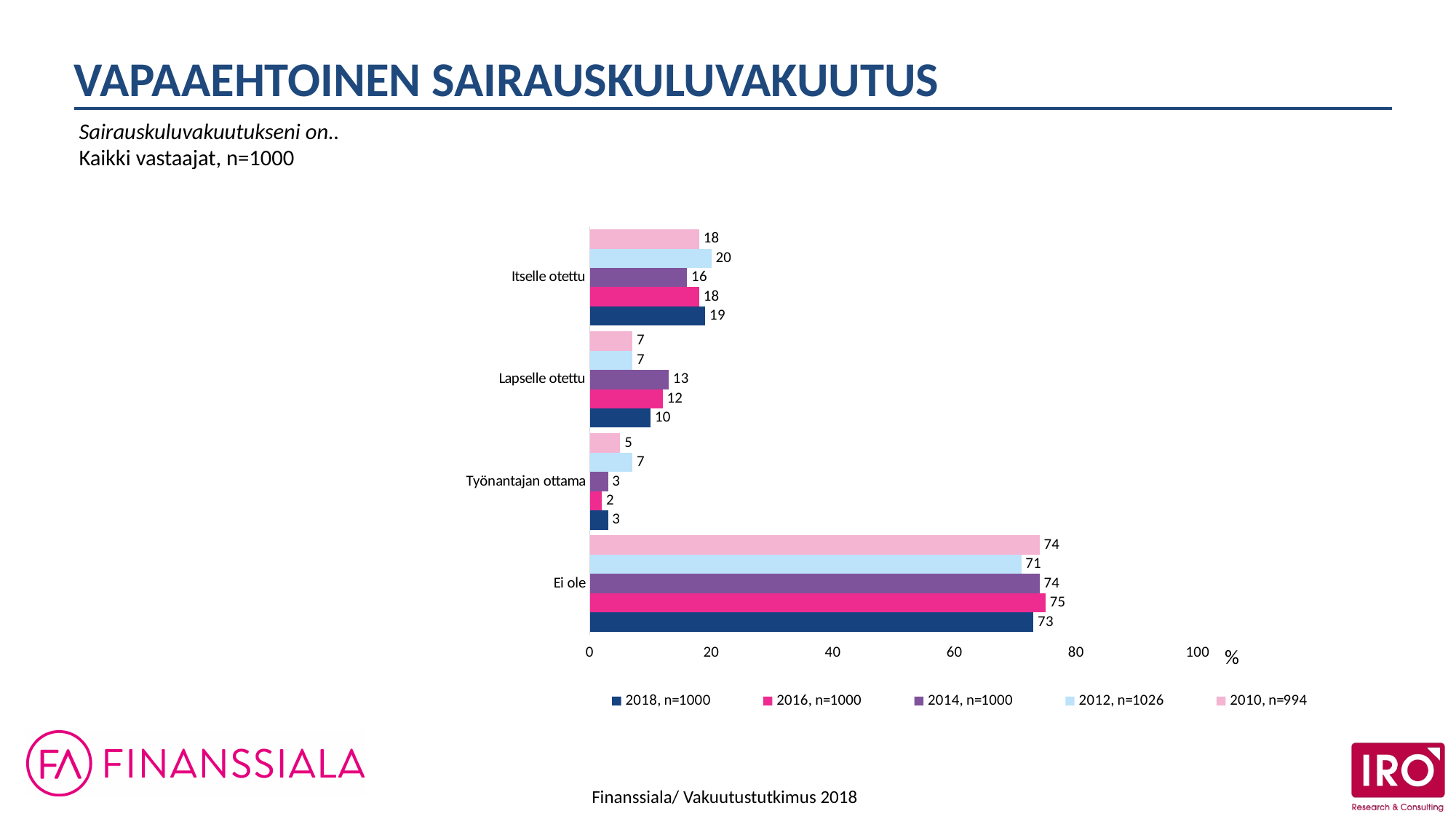
What kind of chart is shown on the slide? Bar chart What is the value for 'Työnantajan ottama' in the 2016, n=1000 series? 2 How many series does the legend list? 5 Which is larger for 'Lapselle otettu': the 2016, n=1000 value or the 2010, n=994 value? 2016, n=1000 What is the value for 'Itselle otettu' in the 2018, n=1000 series? 19 How many categories are shown on the chart? 4 What is the value for 'Ei ole' in the 2012, n=1026 series? 71 What is the difference between the 2016 and 2018 values for 'Ei ole'? 2 Which category has the lowest value in the 2010, n=994 series? Työnantajan ottama What is the value for 'Lapselle otettu' in the 2014, n=1000 series? 13 What is the total of the 2012, n=1026 values for 'Itselle otettu' and 'Lapselle otettu'? 27 Which category has the highest value in the 2018, n=1000 series? Ei ole